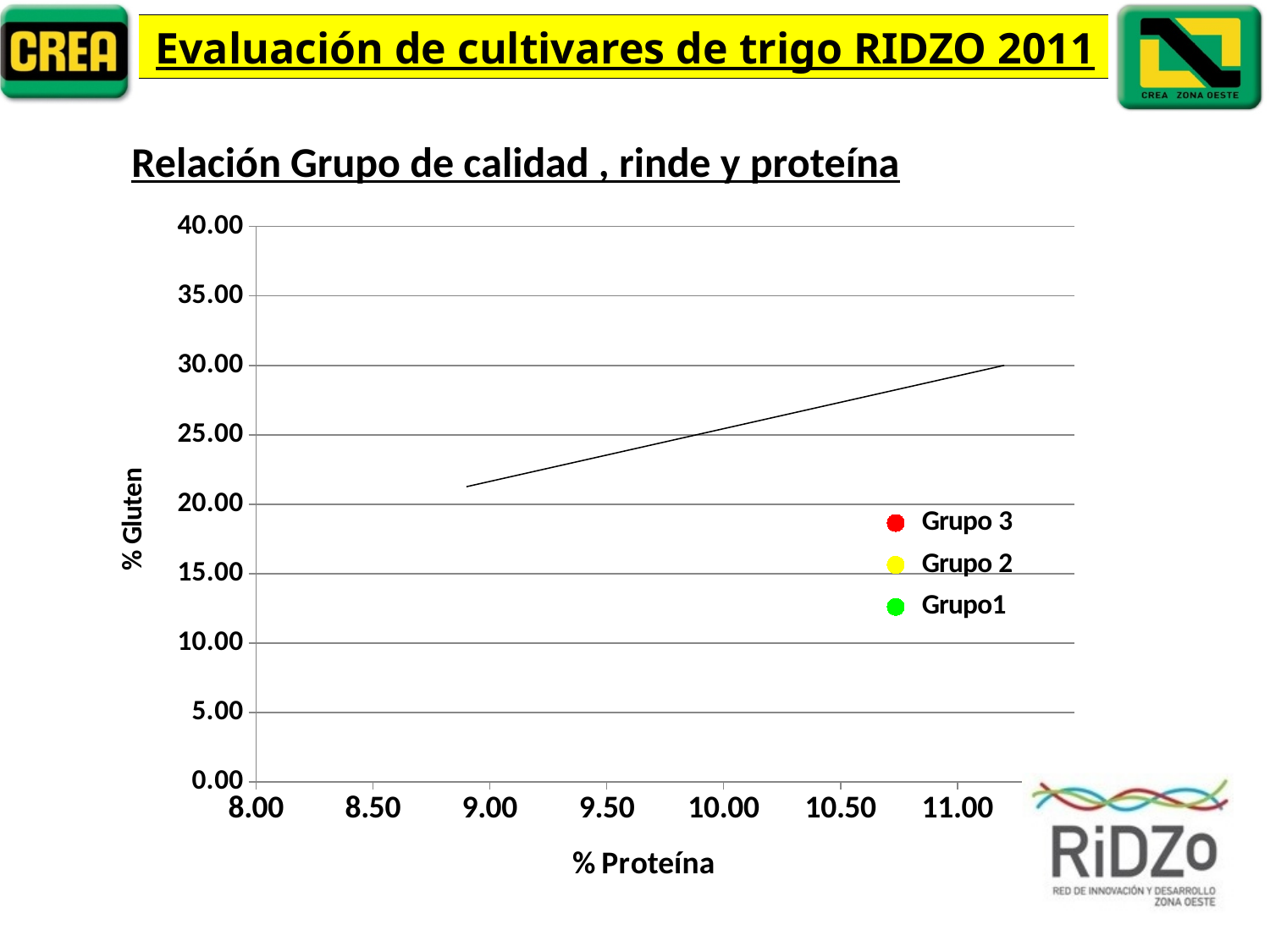
Does % Gluten rise or fall as % Proteína increases along the x axis? rises What kind of chart is shown on the slide? scatter chart with a trend line Is the trend line's % Gluten value at 9.00 % Proteína greater or less than 25.00? less How many series does the legend list? 3 Is the trend line's % Gluten value at 9.00 % Proteína greater or less than 20.00? greater Is the trend line's % Gluten value at 11.00 % Proteína greater or less than 25.00? greater What colour is the legend marker for Grupo 3? red What is the title of the chart? Relación Grupo de calidad , rinde y proteína